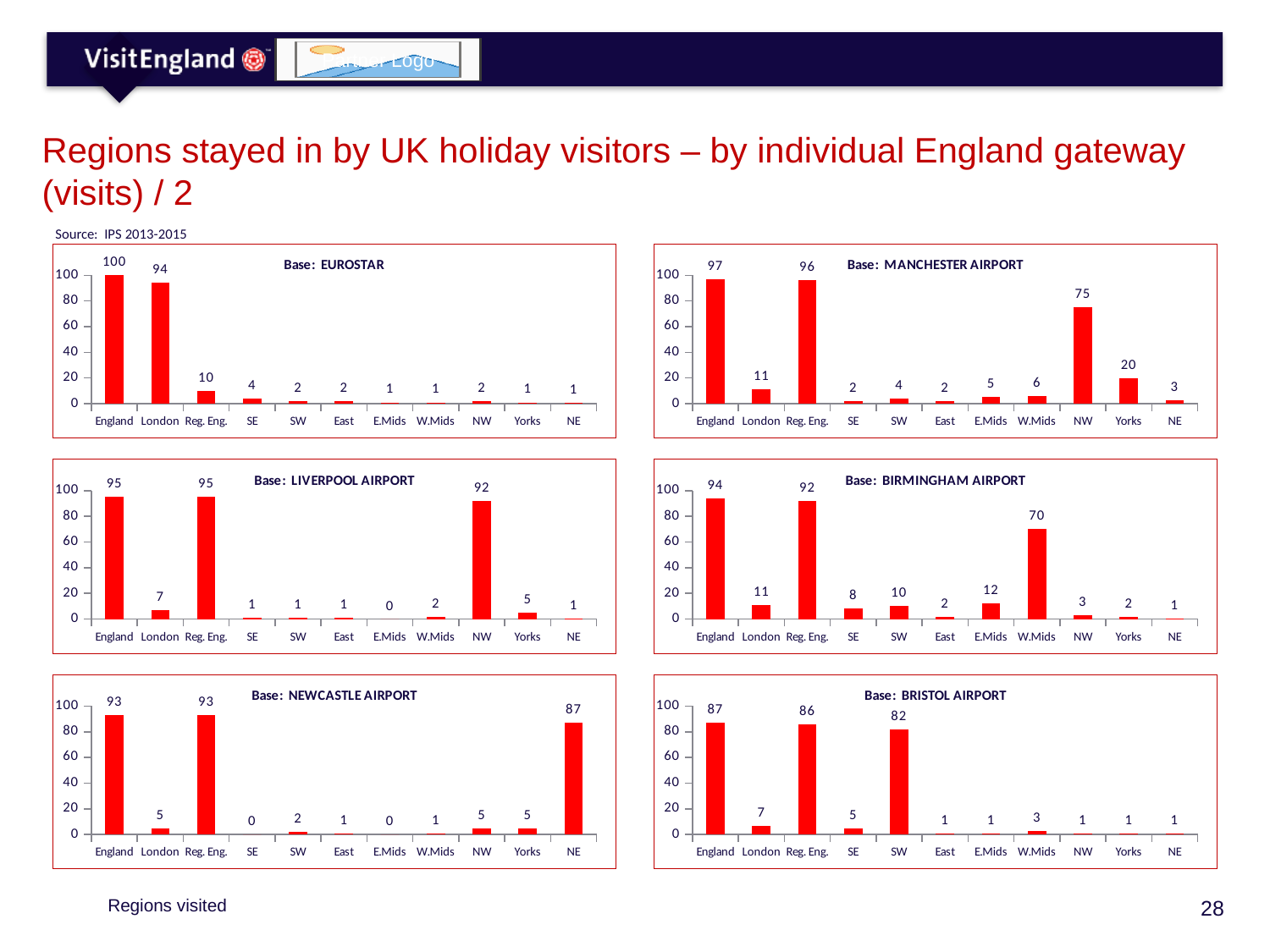
What kind of chart is the Base: LIVERPOOL AIRPORT chart? bar chart In the Base: EUROSTAR chart, what is the value for London? 94 In the Base: BIRMINGHAM AIRPORT chart, what is the value for W.Mids? 70 How many categories are shown on the x axis of the Base: EUROSTAR chart? 11 In the Base: MANCHESTER AIRPORT chart, what is the difference between the values for NW and Yorks? 55 In the Base: LIVERPOOL AIRPORT chart, which region other than England and Reg. Eng. has the highest value? NW In the Base: NEWCASTLE AIRPORT chart, what is the value for NE? 87 In the Base: BIRMINGHAM AIRPORT chart, which is larger, the value for SE or the value for SW? SW In the Base: NEWCASTLE AIRPORT chart, which categories have a value of 0? SE and E.Mids How many charts are shown on the slide? 6 In the Base: MANCHESTER AIRPORT chart, what is the value for NW? 75 In the Base: BRISTOL AIRPORT chart, what is the value for SW? 82